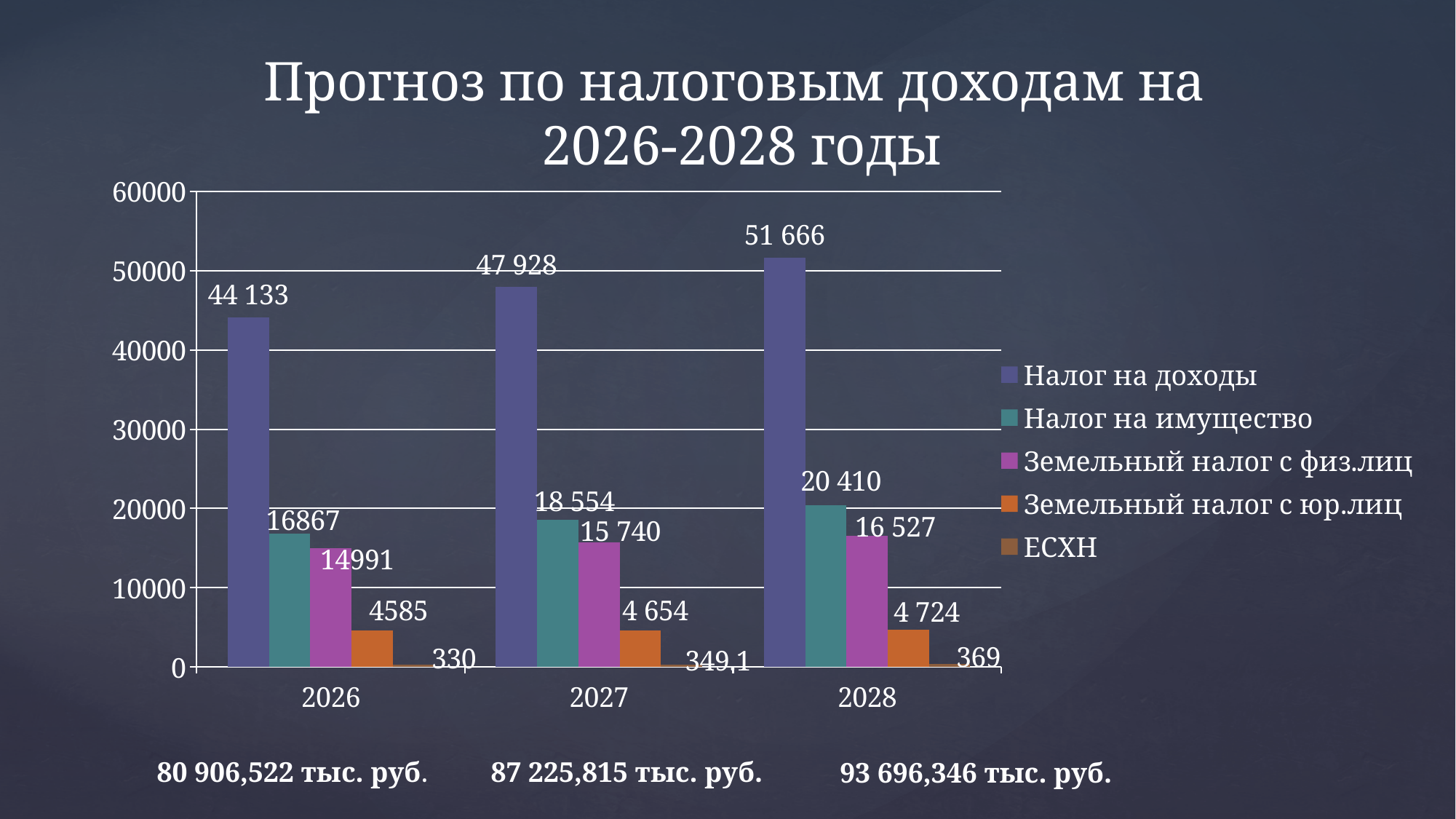
What kind of chart is shown on the slide? bar chart How many series does the legend list? 5 What is the value for Налог на доходы in 2028? 51 666 Which series has the lowest value in 2026? ЕСХН What is the value for Земельный налог с юр.лиц in 2026? 4585 Is the value for Налог на доходы in 2026 greater or less than 40000? greater What is the value for ЕСХН in 2027? 349,1 Which is larger in 2028: Налог на имущество or Земельный налог с физ.лиц? Налог на имущество What is the value for Налог на имущество in 2027? 18 554 Do the values for Земельный налог с физ.лиц rise or fall from 2026 to 2028? rise What is the difference between Налог на доходы in 2027 and in 2026? 3 795 In which year is Налог на доходы highest? 2028